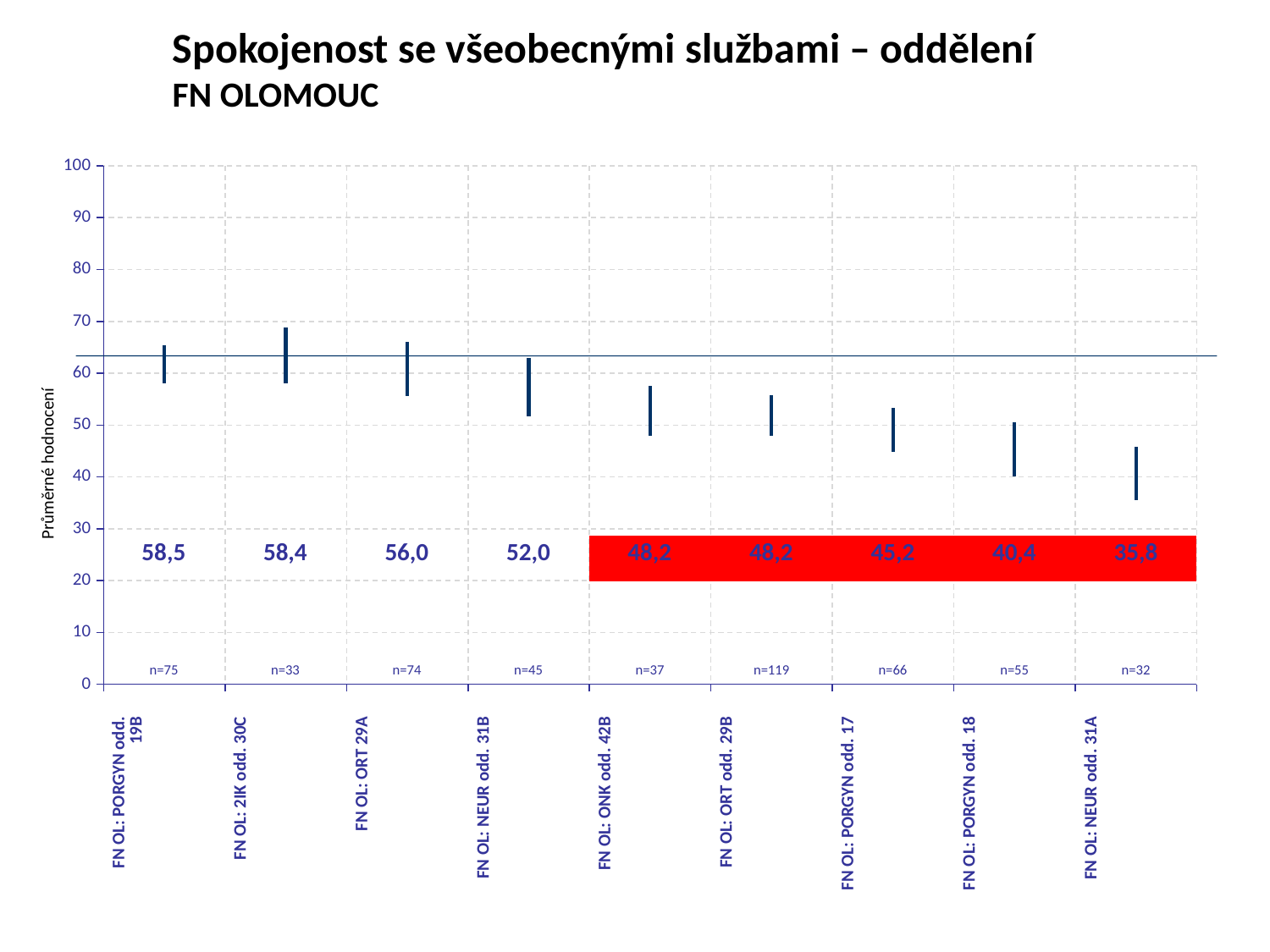
How many departments have their value label highlighted with a red background? 5 What is the average rating value shown for FN OL: PORGYN odd. 19B? 58,5 Do the average rating values rise or fall from left to right along the x axis? fall Which department has the highest average rating on the chart? FN OL: PORGYN odd. 19B What is the difference between the average rating of FN OL: ORT 29A and FN OL: PORGYN odd. 17? 10,8 How many departments are plotted on the chart? 9 What is the average rating value shown for FN OL: PORGYN odd. 18? 40,4 Which department has the lowest average rating on the chart? FN OL: NEUR odd. 31A What is the average rating value shown for FN OL: NEUR odd. 31B? 52,0 What is the label of the vertical axis? Průměrné hodnocení Which has a higher average rating: FN OL: 2IK odd. 30C or FN OL: ONK odd. 42B? FN OL: 2IK odd. 30C What is the sample size (n) shown for FN OL: ORT odd. 29B? n=119